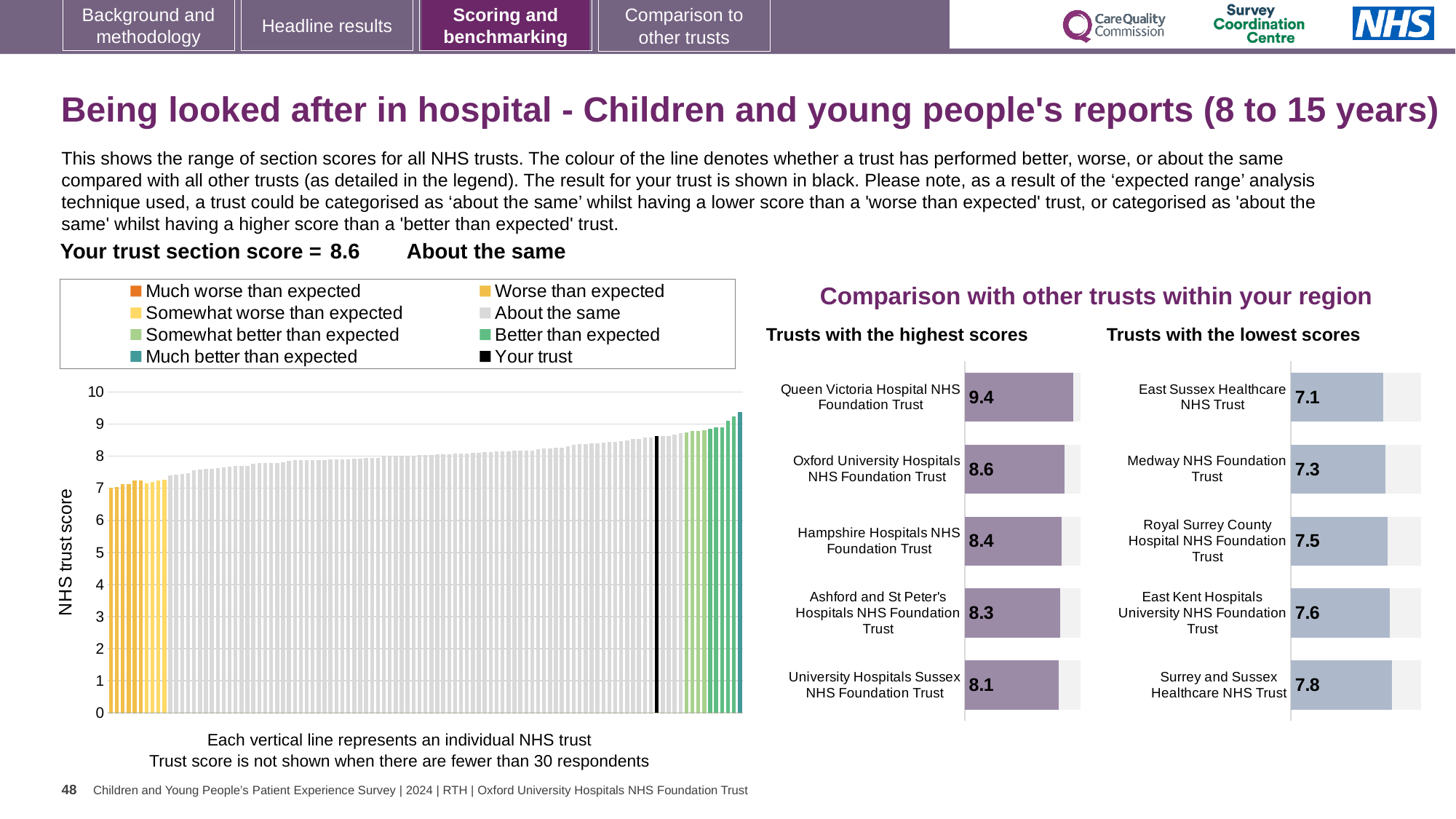
In the 'Trusts with the highest scores' chart, what is the score for Hampshire Hospitals NHS Foundation Trust? 8.4 How many entries does the legend above the large 'NHS trust score' chart list? 8 In the 'Trusts with the highest scores' chart, what is the difference between the scores of Queen Victoria Hospital NHS Foundation Trust and University Hospitals Sussex NHS Foundation Trust? 1.3 In the 'Trusts with the lowest scores' chart, which trust has the lowest score? East Sussex Healthcare NHS Trust In the 'Trusts with the highest scores' chart, which trust has the highest score? Queen Victoria Hospital NHS Foundation Trust How many trusts are shown in the 'Trusts with the lowest scores' chart? 5 In the 'Trusts with the lowest scores' chart, which has the larger score: Royal Surrey County Hospital NHS Foundation Trust or Medway NHS Foundation Trust? Royal Surrey County Hospital NHS Foundation Trust In the large 'NHS trust score' chart on the left, is the value of the black 'Your trust' bar greater or less than 8? greater In the 'Trusts with the lowest scores' chart, what is the score for Medway NHS Foundation Trust? 7.3 In the large 'NHS trust score' chart on the left, do the bar values rise or fall from left to right? Rise What kind of chart is the large chart on the left with the y-axis labelled 'NHS trust score'? Bar chart In the 'Trusts with the highest scores' chart, what is the score for Queen Victoria Hospital NHS Foundation Trust? 9.4